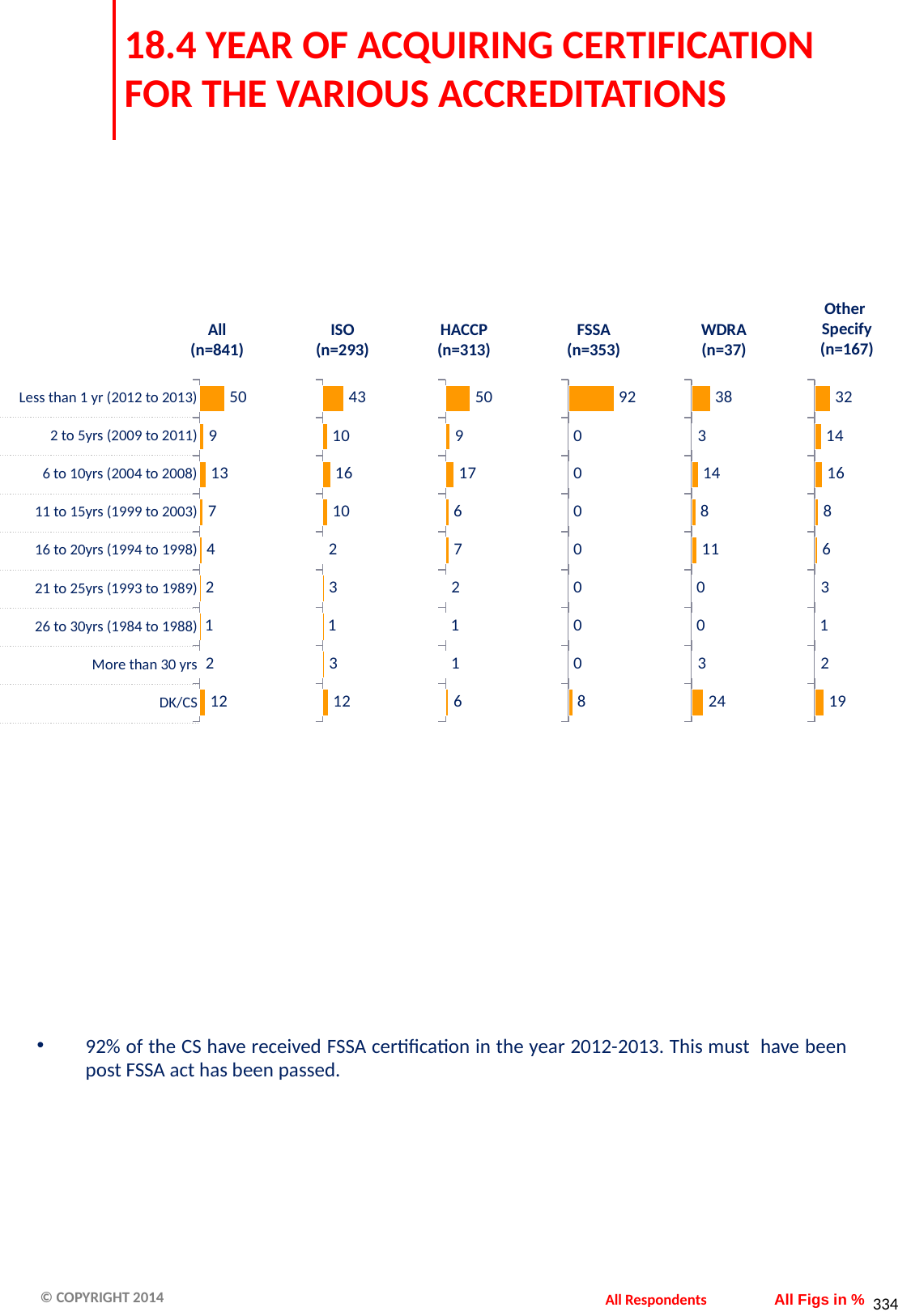
In the Other Specify (n=167) chart, what is the difference between Less than 1 yr (2012 to 2013) and DK/CS? 13 How many separate charts (accreditation groups) are shown on the slide? 6 In the All (n=841) chart, which category has the highest value? Less than 1 yr (2012 to 2013) In the WDRA (n=37) chart, what is the value for DK/CS? 24 In the HACCP (n=313) chart, which category has the lowest value? 26 to 30yrs (1984 to 1988) and More than 30 yrs (both 1) What is the sample size (n) shown for the HACCP chart? n=313 In the WDRA (n=37) chart, which is larger: 6 to 10yrs (2004 to 2008) or 16 to 20yrs (1994 to 1998)? 6 to 10yrs (2004 to 2008) In the FSSA (n=353) chart, what is the value for Less than 1 yr (2012 to 2013)? 92 How many categories does each chart on the slide show? 9 In the ISO (n=293) chart, what is the value for 6 to 10yrs (2004 to 2008)? 16 In the All (n=841) chart, what is the difference between Less than 1 yr (2012 to 2013) and 2 to 5yrs (2009 to 2011)? 41 What type of chart is used on the slide? Bar chart